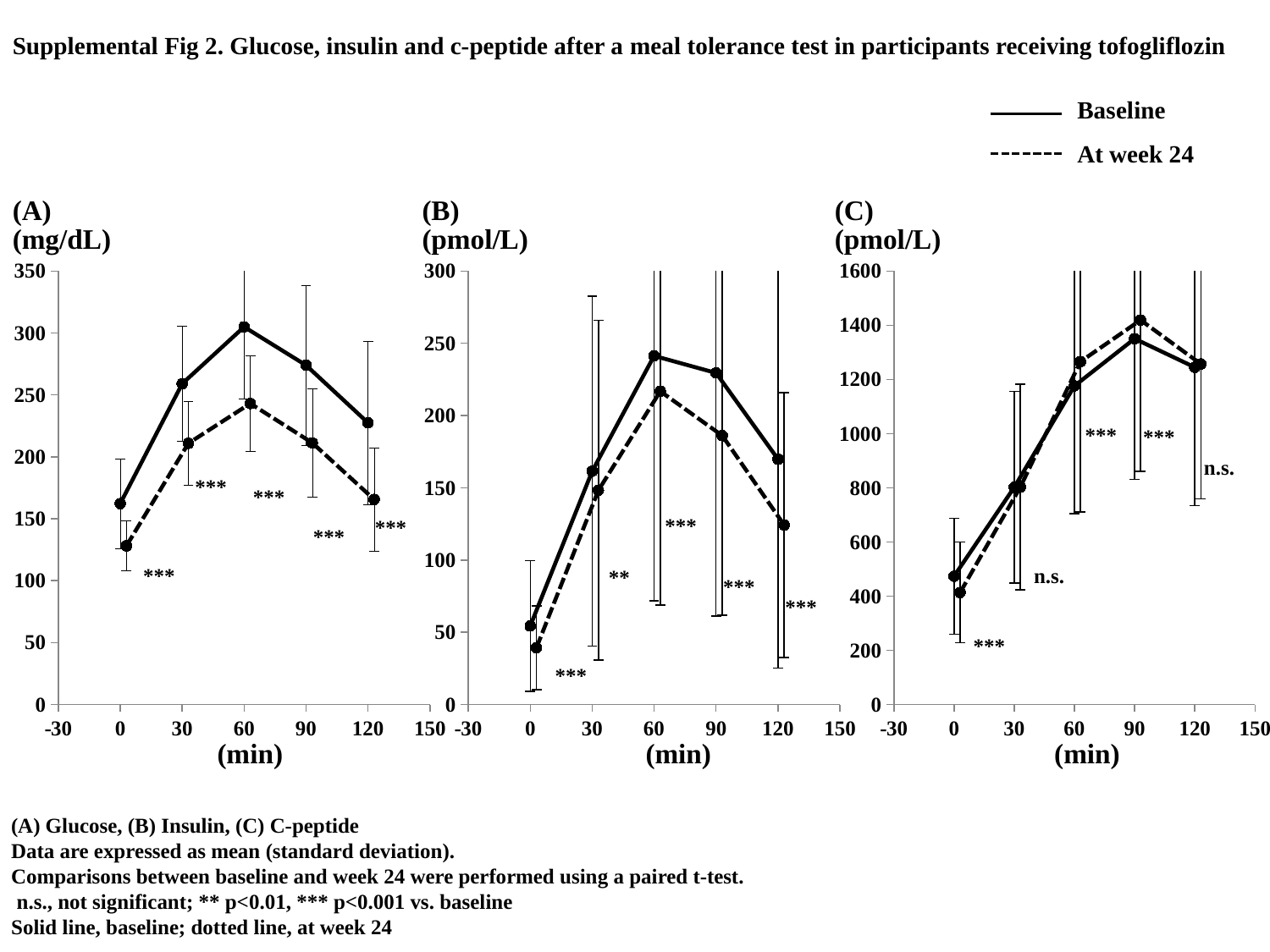
In chart (A), how many time points are plotted for the Baseline series? 5 In chart (A), at 60 min, which series has the larger value, Baseline or At week 24? Baseline In chart (A), at which time point does the Baseline series reach its highest value? 60 min What unit is shown on the y axis of chart (C)? pmol/L In chart (B), at which time point does the Baseline series reach its highest value? 60 min In chart (A), is the Baseline value at 60 min greater or less than 250? greater In chart (A), is the At week 24 value at 0 min greater or less than 150? less What kind of chart is chart (A)? line chart In chart (C), at which time point does the At week 24 series reach its lowest value? 0 min How many series does the legend list? 2 In chart (A), does the Baseline series rise or fall from 60 min to 120 min? fall In chart (B), is the At week 24 value at 120 min greater or less than 150? less